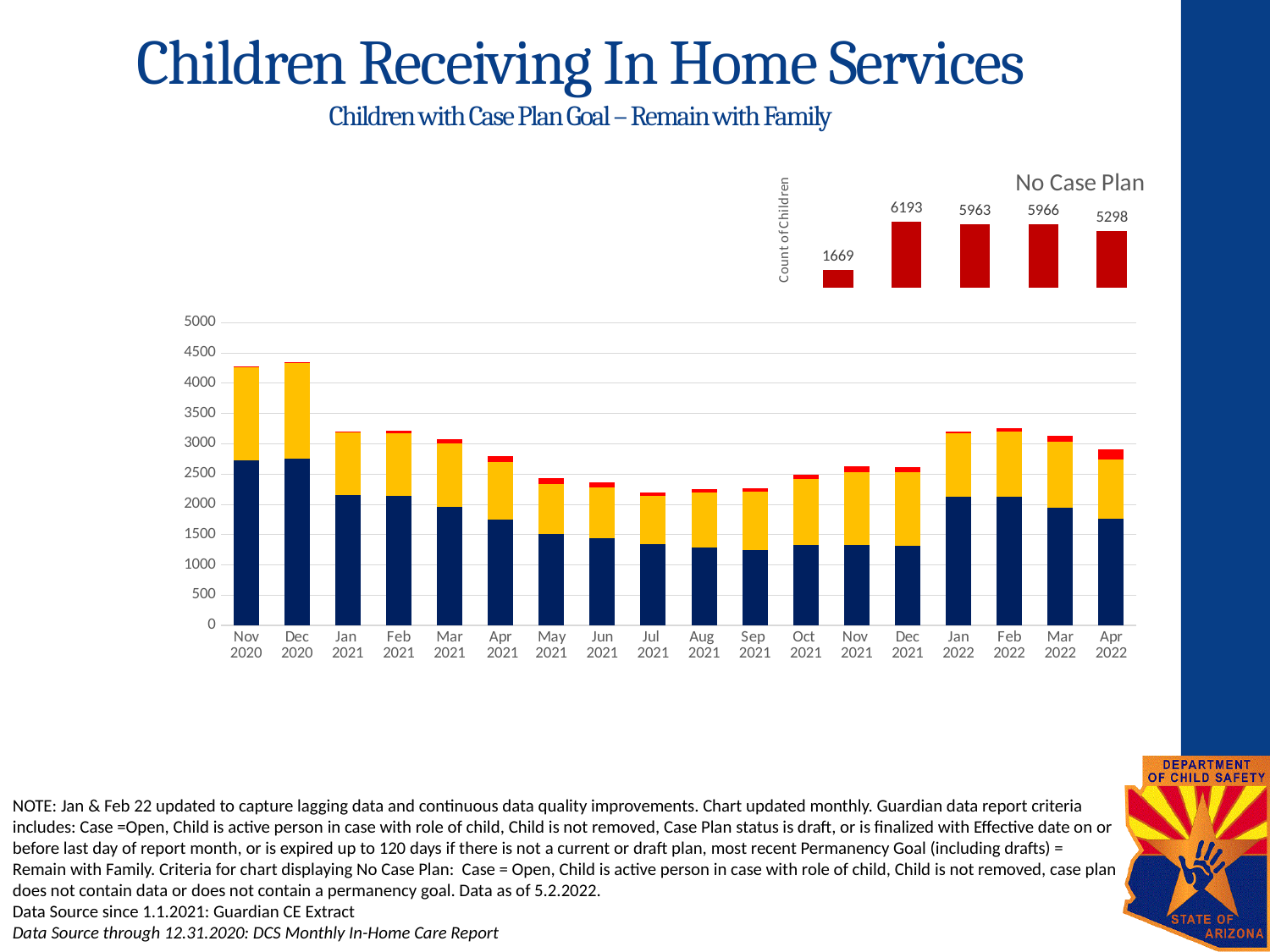
In the 'No Case Plan' chart at the top right, what is the highest value shown? 6193 What kind of chart is the large chart at the bottom of the slide? Stacked bar chart In the 'No Case Plan' chart at the top right, what is the value of the first (leftmost) bar? 1669 In the 'No Case Plan' chart at the top right, how many bars are plotted? 5 In the large stacked chart at the bottom, is the total bar height for Nov 2020 greater or less than 4000? greater In the 'No Case Plan' chart at the top right, what is the lowest value shown? 1669 In the 'No Case Plan' chart at the top right, what is the label on the vertical axis? Count of Children In the 'No Case Plan' chart at the top right, what is the value of the last (rightmost) bar? 5298 In the 'No Case Plan' chart at the top right, what is the difference between the highest value (6193) and the lowest value (1669)? 4524 In the 'No Case Plan' chart at the top right, what is the value of the second bar? 6193 In the large stacked chart at the bottom, how many months are shown on the x axis? 18 In the large stacked chart at the bottom, is the total bar height for Sep 2021 greater or less than 2500? less